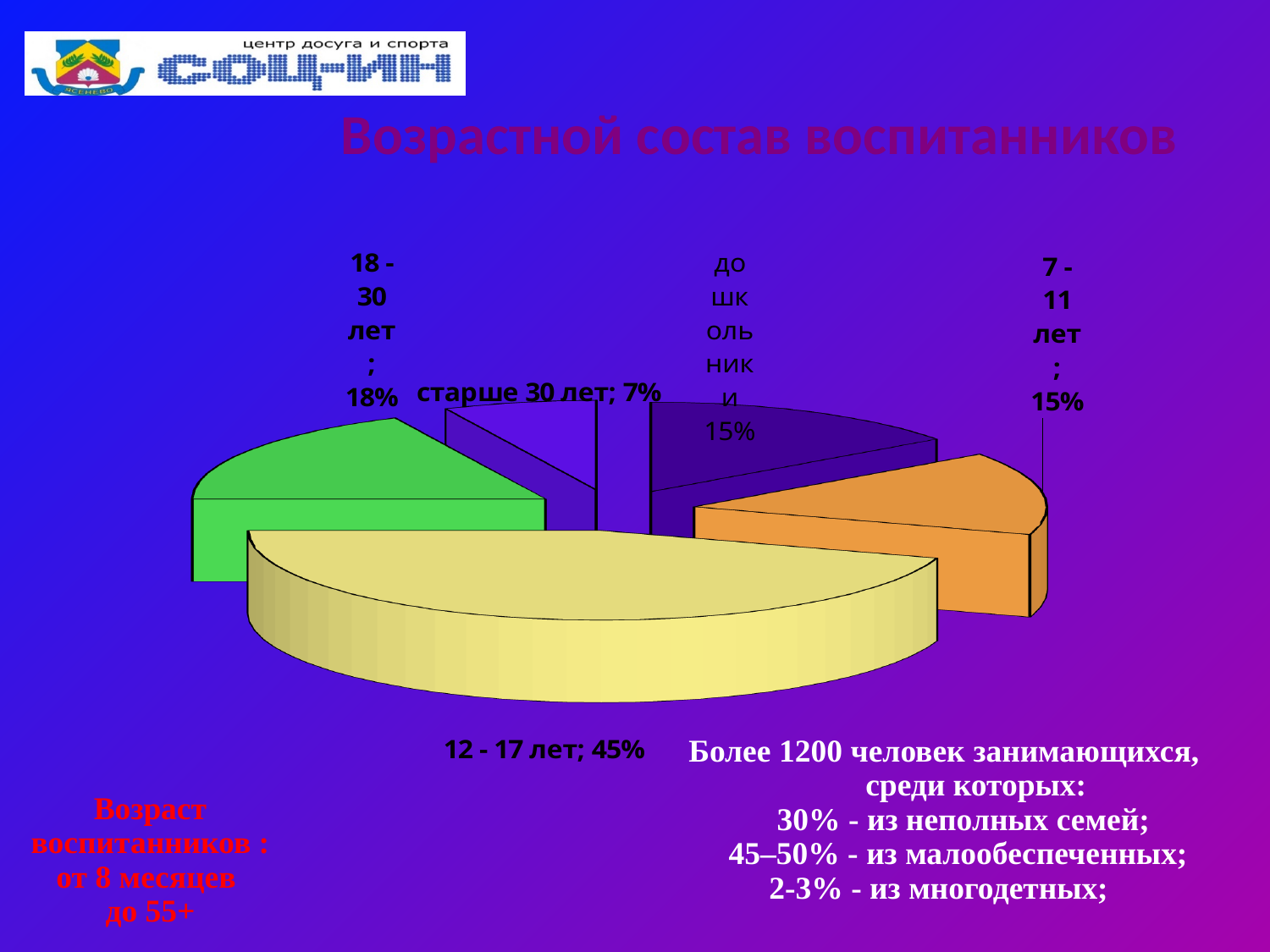
What is the value shown for старше 30 лет? 7% Which age group has the largest slice of the pie? 12 - 17 лет What is the value shown for 7 - 11 лет? 15% What is the difference in percentage points between the 12 - 17 лет slice and the 18 - 30 лет slice? 27 What share of the pie is the slice for 12 - 17 лет? 45% What is the value shown for 18 - 30 лет? 18% What is the value shown for дошкольники? 15% Which age group has the smallest slice of the pie? старше 30 лет Which is larger, the slice for 18 - 30 лет or the slice for старше 30 лет? 18 - 30 лет What kind of chart is shown on the slide? pie chart How many slices does the pie chart have? 5 What is the title of the chart? Возрастной состав воспитанников